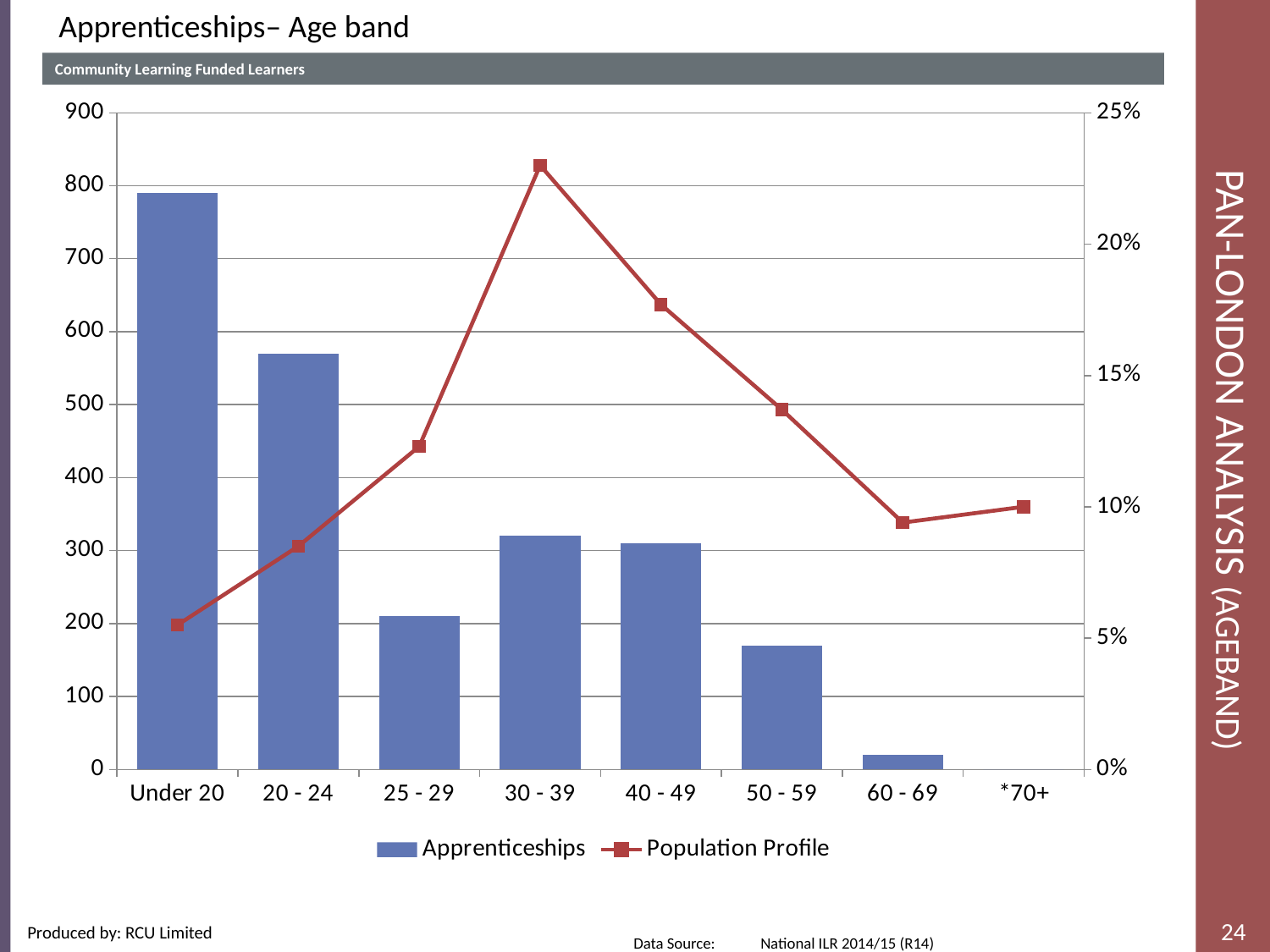
Which has the larger Apprenticeships value, Under 20 or 20 - 24? Under 20 How many age bands are shown on the x axis? 8 Is the Population Profile value for 30 - 39 greater or less than 20%? greater Is the Apprenticeships value for 20 - 24 greater or less than 500? greater Which age band has the highest Apprenticeships value? Under 20 Is the Apprenticeships value for Under 20 greater or less than 700? greater Which age band has the lowest Population Profile value? Under 20 Which age band has the highest Population Profile value? 30 - 39 How many series does the legend list? 2 Does the Population Profile line rise or fall from 30 - 39 to 60 - 69? fall